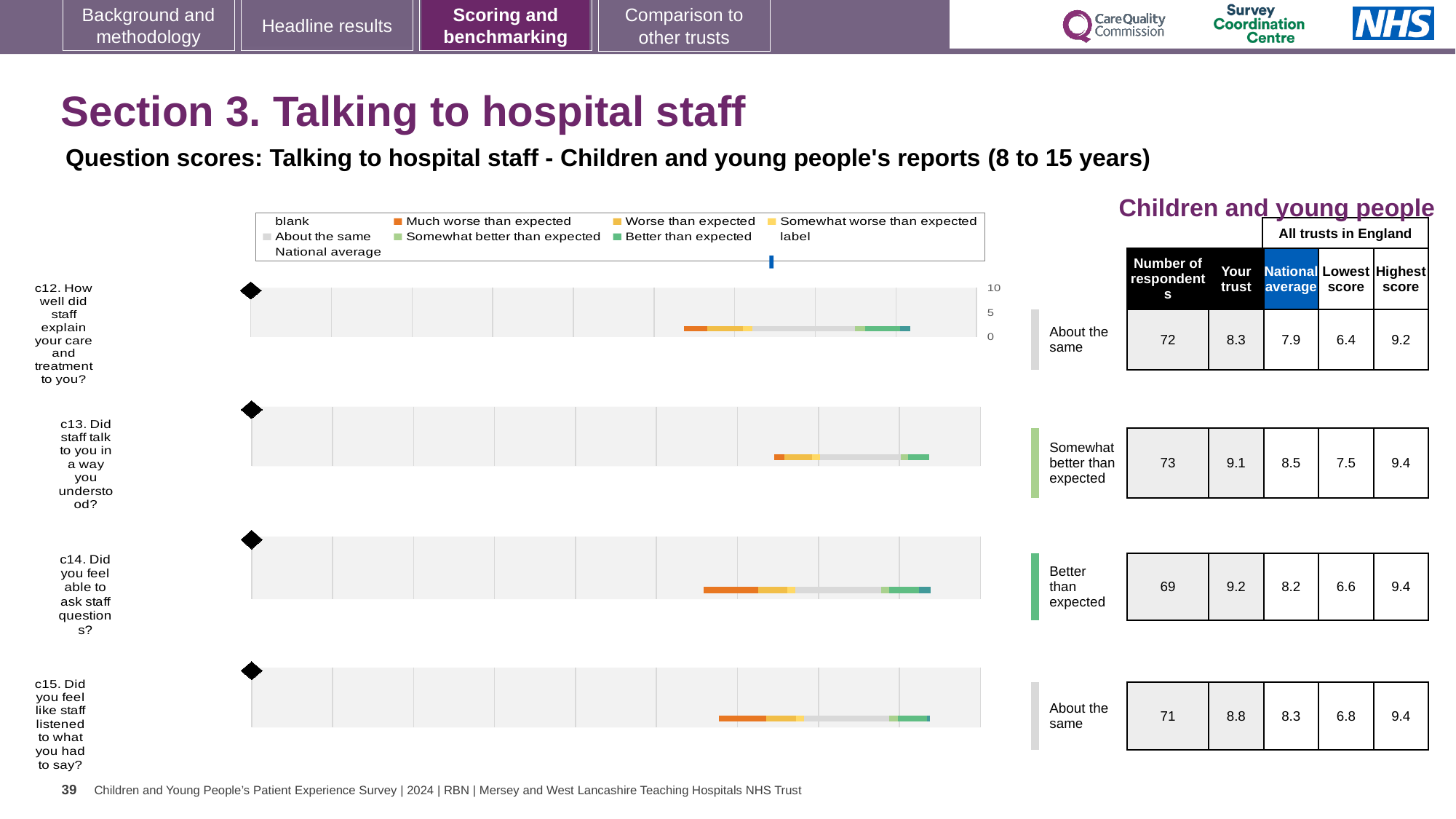
What is the national average score for c13 (Did staff talk to you in a way you understood?)? 8.5 Which question has the lowest 'Your trust' score? c12. How well did staff explain your care and treatment to you? How many questions (c12 to c15) are plotted on the slide? 4 Which question has the highest 'Your trust' score? c14. Did you feel able to ask staff questions? For c13, which is larger: the 'Your trust' score or the national average? Your trust What kind of chart is used for the question scores on this slide? bar chart What is the 'Your trust' score for c12 (How well did staff explain your care and treatment to you?)? 8.3 What is the number of respondents for c14 (Did you feel able to ask staff questions?)? 69 What benchmark category is shown for c14 (Did you feel able to ask staff questions?)? Better than expected What colour does the legend use for 'Much worse than expected'? orange What is the highest score across all trusts in England for c15 (Did you feel like staff listened to what you had to say?)? 9.4 What is the difference between the 'Your trust' score and the national average for c12? 0.4